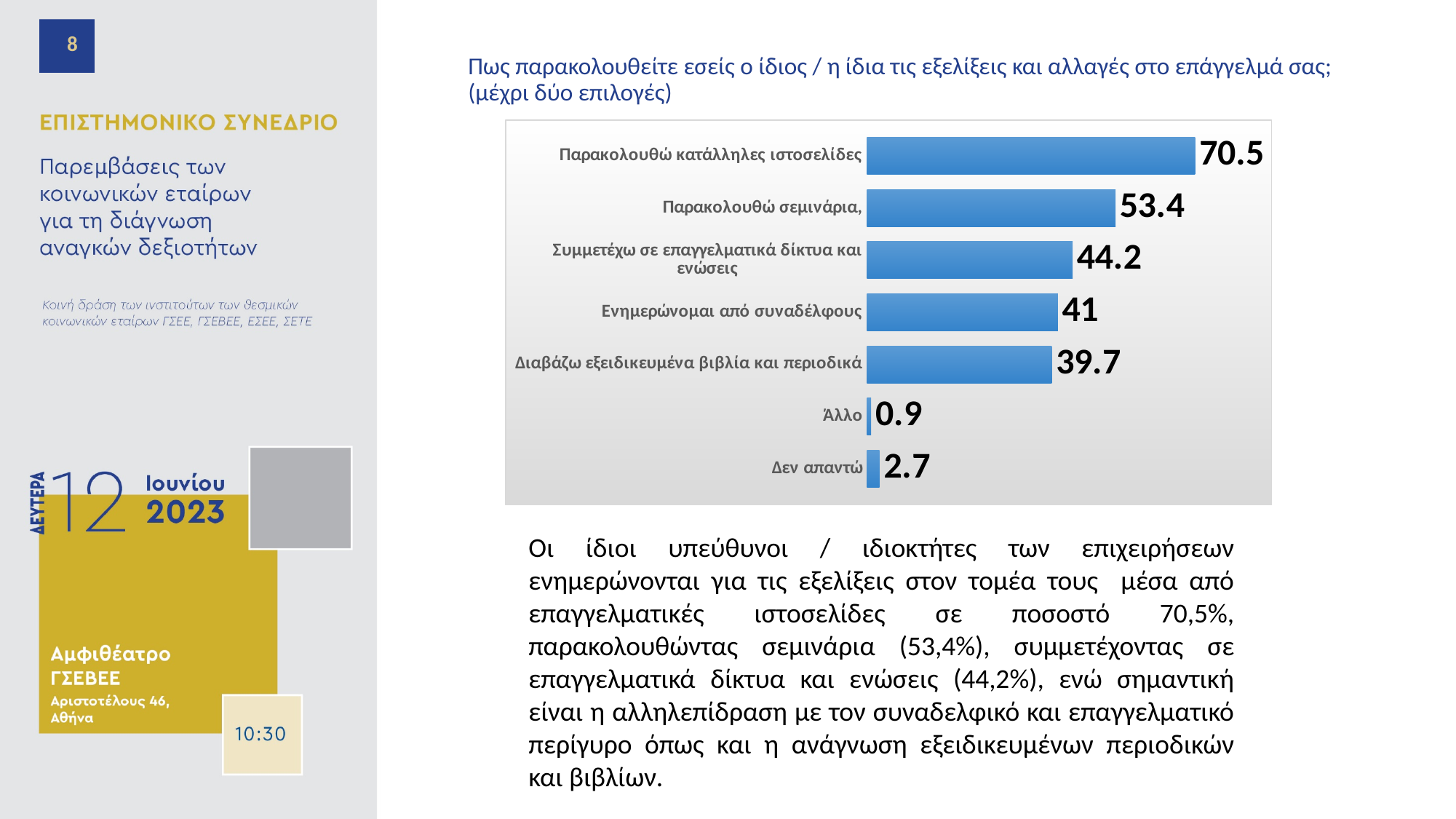
How many categories are shown in the chart? 7 Which category has the highest value? Παρακολουθώ κατάλληλες ιστοσελίδες What is the difference between the values for "Παρακολουθώ κατάλληλες ιστοσελίδες" and "Παρακολουθώ σεμινάρια"? 17.1 What value is shown for "Δεν απαντώ"? 2.7 Which category has the lowest value? Άλλο What value is shown for "Ενημερώνομαι από συναδέλφους"? 41 What colour are the bars in the chart? Blue What value is shown for "Παρακολουθώ σεμινάρια"? 53.4 What is the difference between the values for "Δεν απαντώ" and "Άλλο"? 1.8 What kind of chart is shown on the slide? Bar chart Which is larger: the value for "Συμμετέχω σε επαγγελματικά δίκτυα και ενώσεις" or the value for "Διαβάζω εξειδικευμένα βιβλία και περιοδικά"? Συμμετέχω σε επαγγελματικά δίκτυα και ενώσεις What value is shown for "Παρακολουθώ κατάλληλες ιστοσελίδες"? 70.5